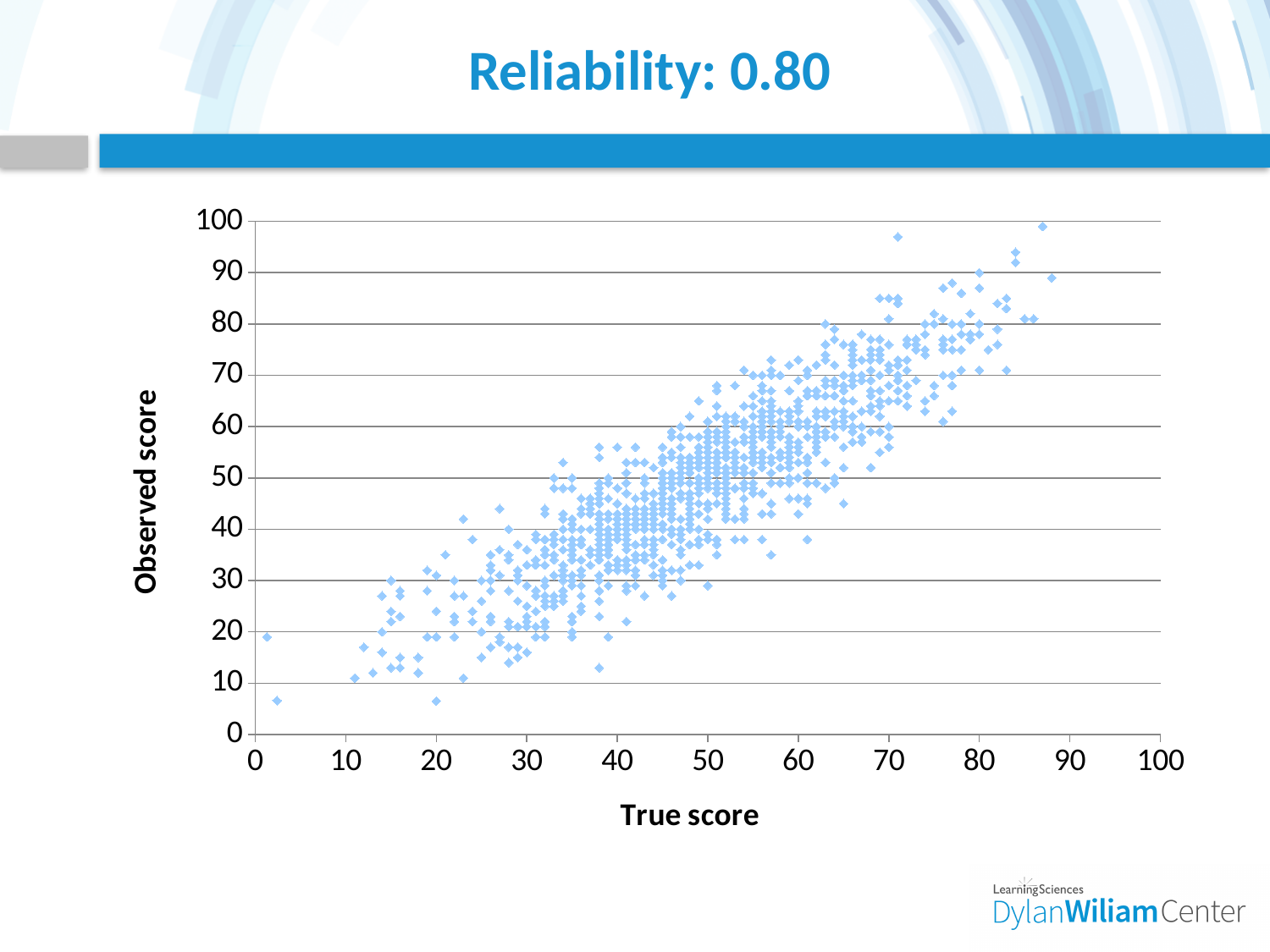
What is the maximum value shown on the x axis? 100 What is the interval between tick marks on the y axis? 10 What is the label of the x axis? True score As the true score increases along the x axis, does the observed score generally rise or fall? rise What is the maximum value shown on the y axis? 100 Is the highest observed score plotted greater or less than 90? greater Is the lowest observed score plotted greater or less than 10? less What kind of chart is shown on the slide? scatter plot Is the largest true score plotted greater or less than 90? less What is the title of the chart on the slide? Reliability: 0.80